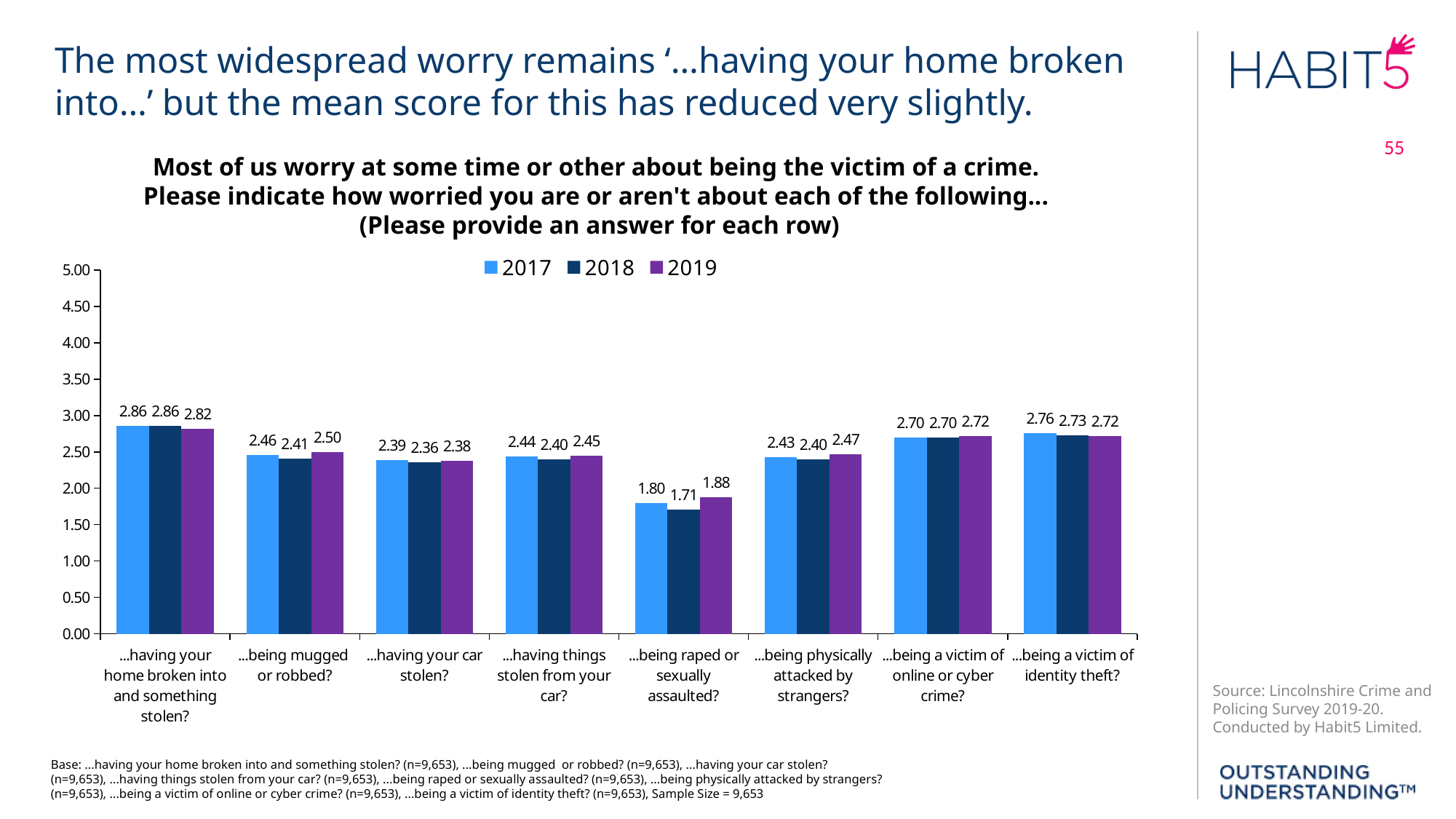
What is the 2017 value for '...being a victim of identity theft?' 2.76 Is the 2018 value for '...being a victim of online or cyber crime?' greater or less than 2.50? greater Which category has the highest 2019 value? ...having your home broken into and something stolen? What is the 2019 value for '...having your home broken into and something stolen?' 2.82 What kind of chart is shown on the slide? bar chart Which is larger: the 2019 value for '...being mugged or robbed?' or the 2019 value for '...having your car stolen?' ...being mugged or robbed? How many series does the legend list? 3 Which years are listed in the chart legend? 2017, 2018, 2019 What is the 2018 value for '...being raped or sexually assaulted?' 1.71 How many categories are shown on the x axis? 8 Which category has the lowest 2017 value? ...being raped or sexually assaulted? What is the difference between the 2019 and 2018 values for '...being raped or sexually assaulted?' 0.17